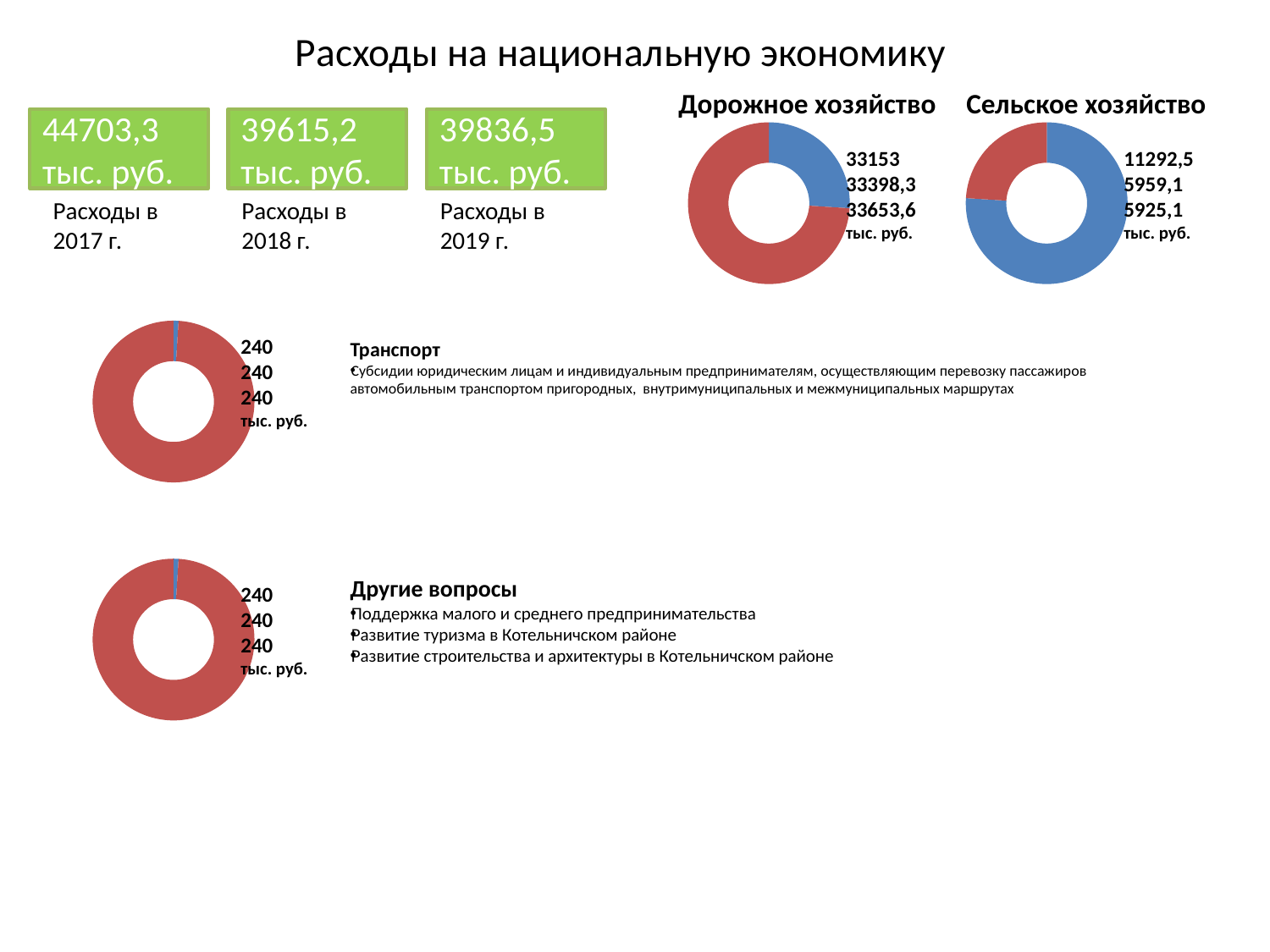
What kind of chart is the 'Дорожное хозяйство' chart? Doughnut (pie) chart How many doughnut charts are shown on the slide? 4 In the 'Дорожное хозяйство' chart, which slice is larger, the blue one or the red one? The red one What is the title of the doughnut chart at the top right of the slide? Сельское хозяйство In the 'Сельское хозяйство' chart, which slice is larger, the blue one or the red one? The blue one What is the last value listed beside the 'Дорожное хозяйство' chart? 33653,6 What is the first value listed beside the 'Дорожное хозяйство' chart? 33153 In the 'Транспорт' doughnut chart, which colour takes up almost the entire ring? Red How many slices does the 'Сельское хозяйство' doughnut chart have? 2 What is the first value listed beside the 'Сельское хозяйство' chart? 11292,5 What unit is given for the values beside the 'Другие вопросы' doughnut chart? тыс. руб. What value is listed three times beside the 'Транспорт' doughnut chart? 240